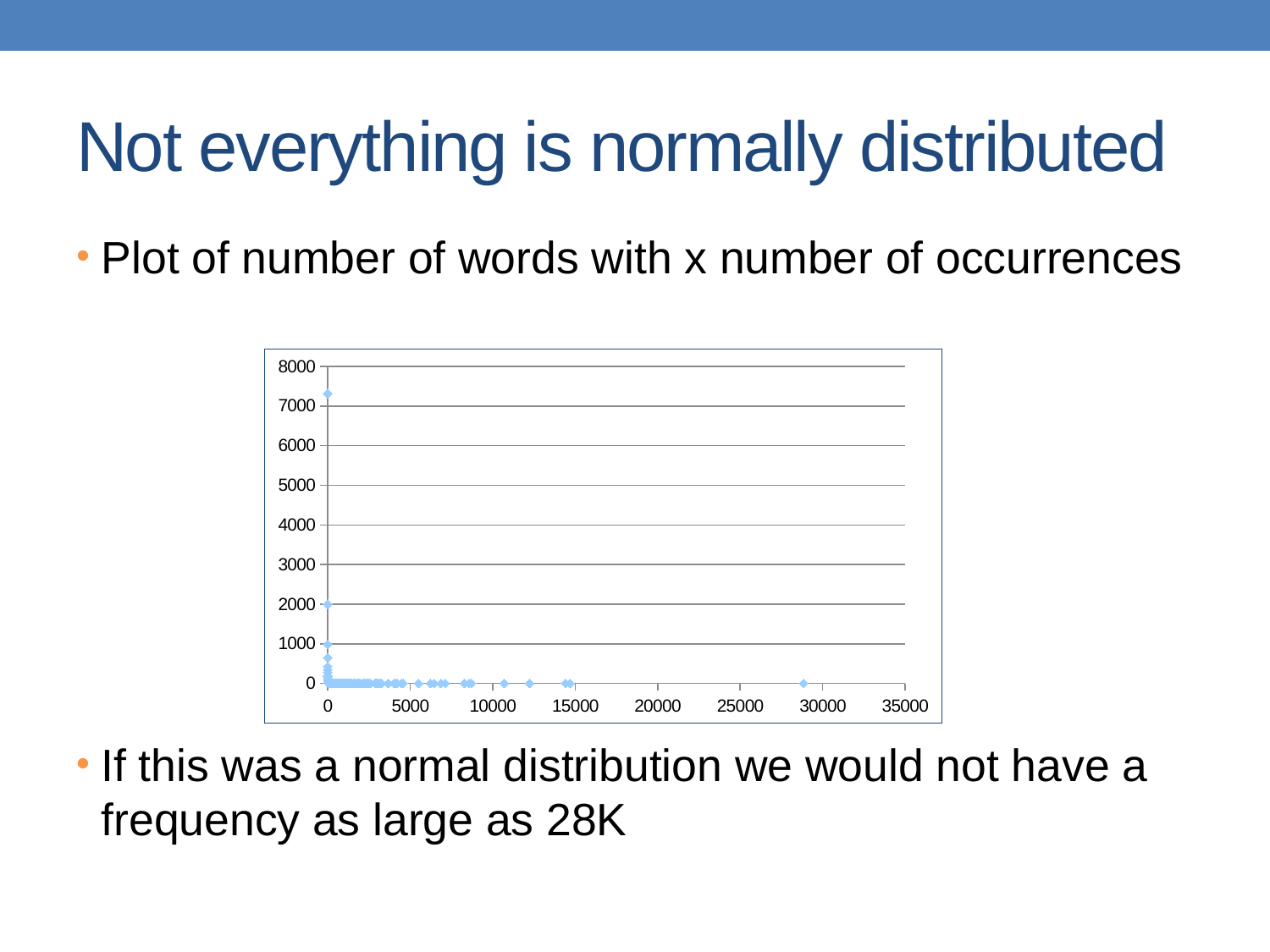
What kind of chart is shown on the slide? scatter plot Is the highest point on the chart greater or less than 7000 on the y axis? greater Is the highest point on the chart greater or less than 8000 on the y axis? less Is the y value of the rightmost point on the chart (near x = 28000) greater or less than 1000? less Do the plotted y values generally rise or fall as x increases along the x axis? fall What is the largest value labelled on the x axis of the chart? 35000 What is the largest value labelled on the y axis of the chart? 8000